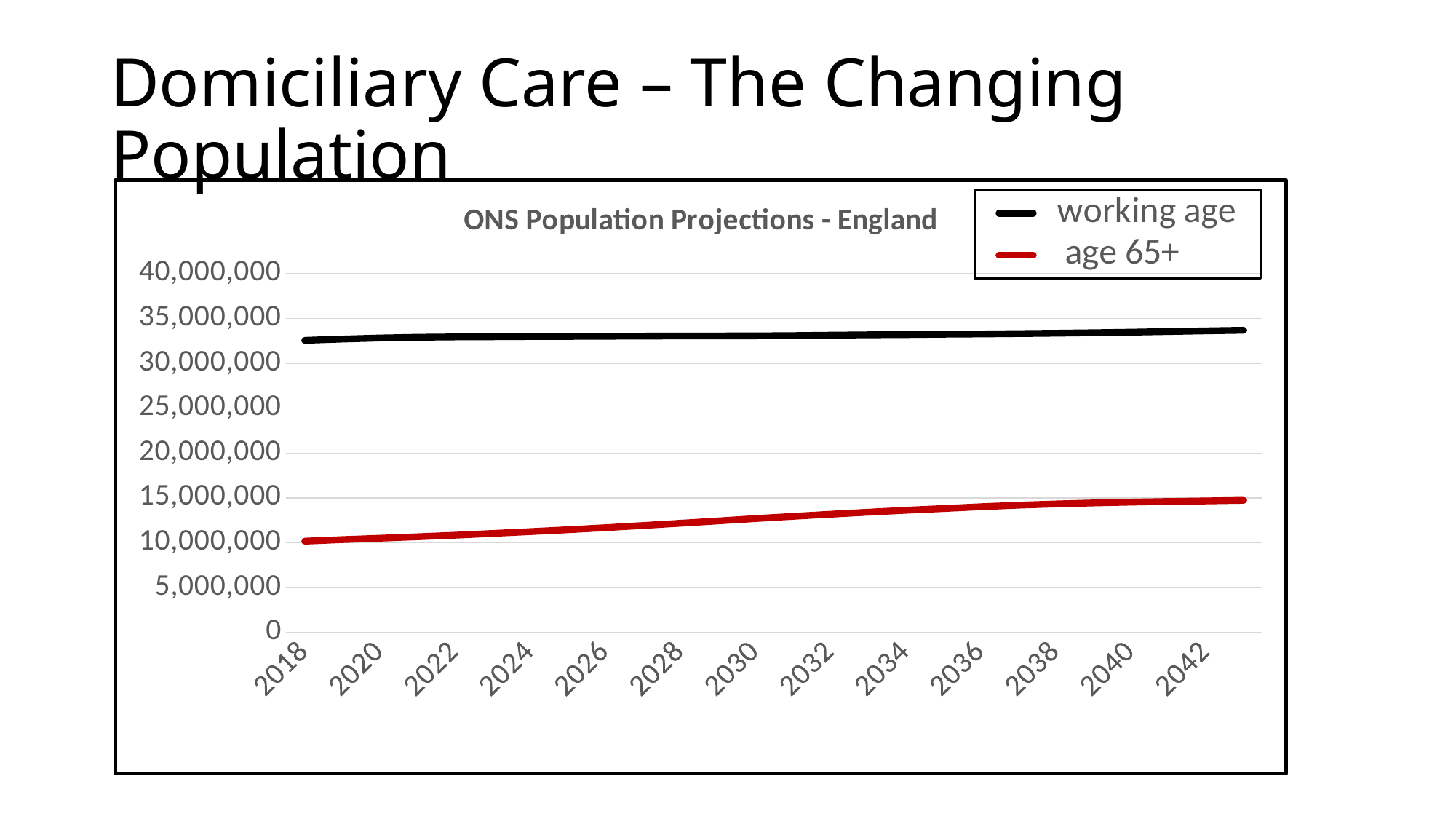
Does the working age series rise or fall from 2018 to 2042? rise Does the age 65+ series rise or fall from 2018 to 2042? rise Is the value for age 65+ in 2030 greater or less than 15,000,000? less Which colour is used for the age 65+ series? red What is the title of the chart? ONS Population Projections - England Is the value for working age in 2042 greater or less than 35,000,000? less Is the value for age 65+ in 2042 greater or less than 10,000,000? greater What kind of chart is shown on the slide? line chart How many year labels are shown on the x axis? 13 Which series has the higher values throughout the chart, working age or age 65+? working age How many series does the legend list? 2